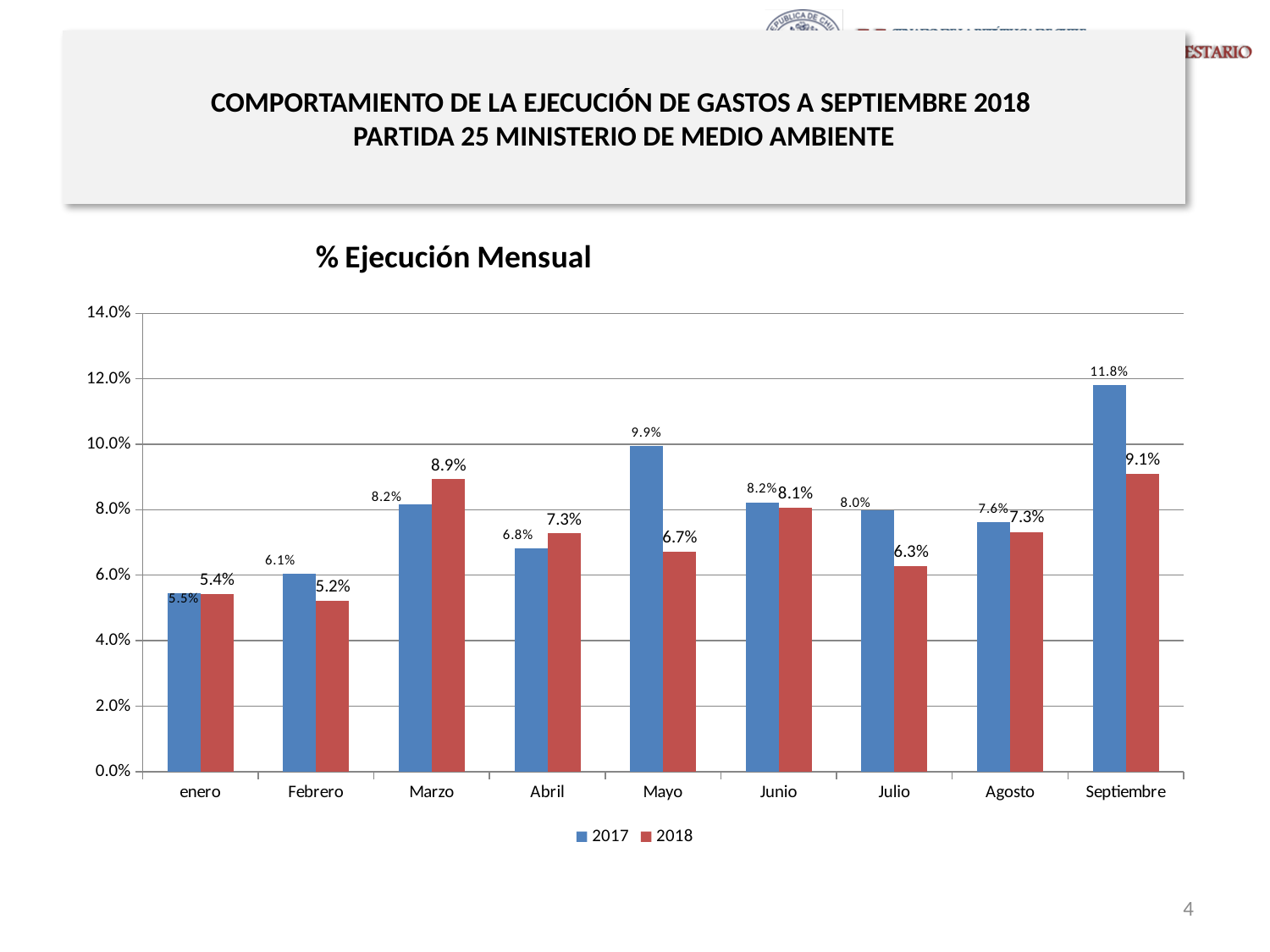
What kind of chart is shown? Bar chart What is the 2018 value for Julio? 6.3% What is the 2018 value for Marzo? 8.9% How many months are shown on the x axis? 9 What is the 2017 value for Mayo? 9.9% Which month has the highest 2017 value? Septiembre How many series does the legend list? 2 Which month has the lowest 2018 value? Febrero What is the difference between the 2017 and 2018 values for Septiembre? 2.7% Which is larger for Mayo, the 2017 value or the 2018 value? 2017 Which is larger for Abril, the 2017 value or the 2018 value? 2018 What is the difference between the 2018 values for Marzo and Abril? 1.6%